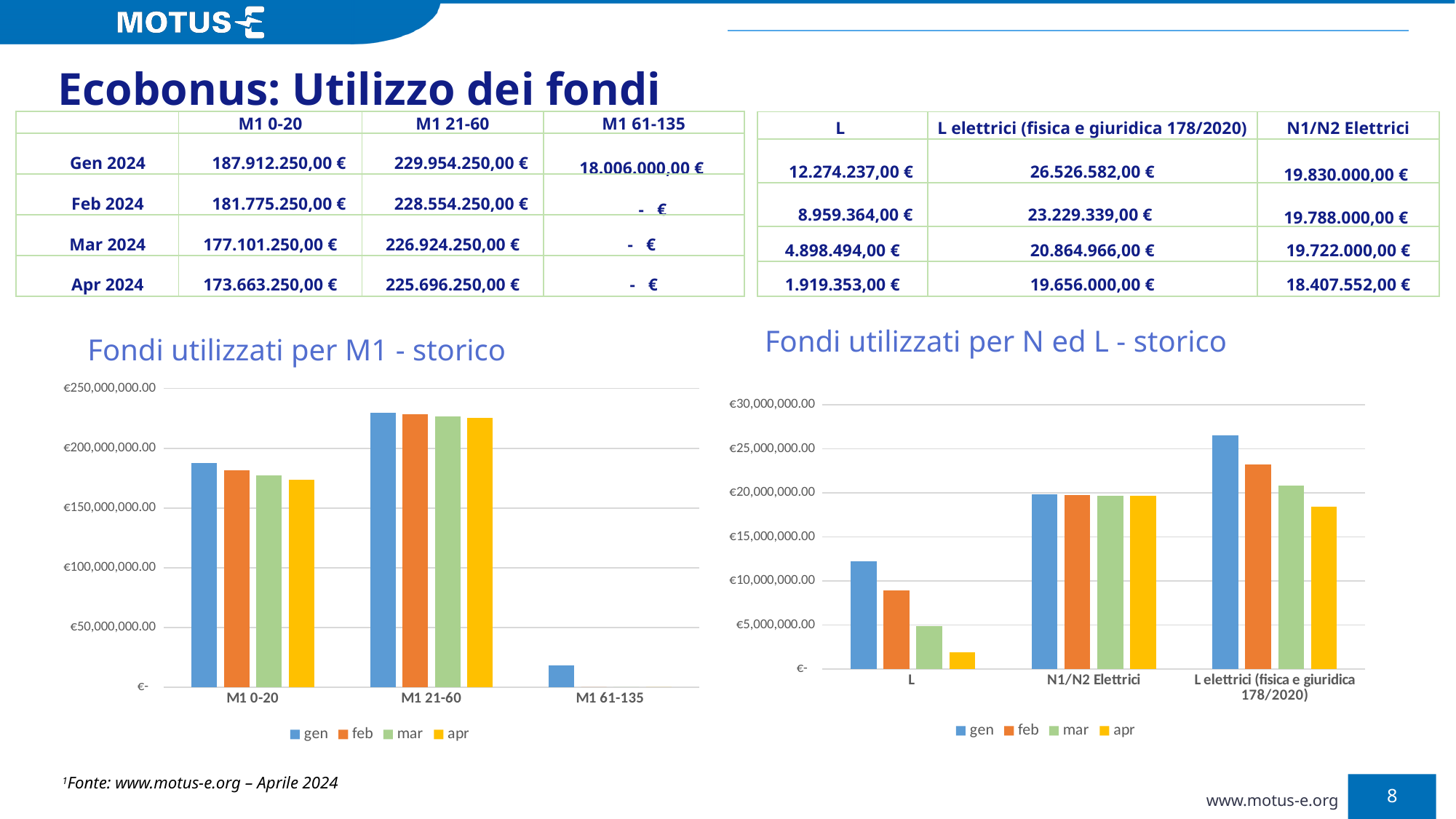
In the chart 'Fondi utilizzati per N ed L - storico', which is larger: the gen bar for L or the gen bar for N1/N2 Elettrici? N1/N2 Elettrici In the chart 'Fondi utilizzati per N ed L - storico', how many categories are shown on the x axis? 3 In the chart 'Fondi utilizzati per M1 - storico', which category has the lowest values? M1 61-135 In the chart 'Fondi utilizzati per M1 - storico', is the gen value for M1 21-60 greater or less than €200,000,000.00? greater What kind of chart is 'Fondi utilizzati per M1 - storico'? bar chart In the chart 'Fondi utilizzati per N ed L - storico', do the bars for category L rise or fall from gen to apr? fall According to the table above the chart 'Fondi utilizzati per M1 - storico', what is the value for M1 0-20 in Gen 2024? 187.912.250,00 € In the chart 'Fondi utilizzati per M1 - storico', how many categories are shown on the x axis? 3 In the chart 'Fondi utilizzati per N ed L - storico', is the apr value for L greater or less than €5,000,000.00? less In the chart 'Fondi utilizzati per M1 - storico', how many series does the legend list? 4 In the chart 'Fondi utilizzati per M1 - storico', is the gen value for M1 61-135 greater or less than €50,000,000.00? less In the chart 'Fondi utilizzati per N ed L - storico', which category has the highest gen bar? L elettrici (fisica e giuridica 178/2020)